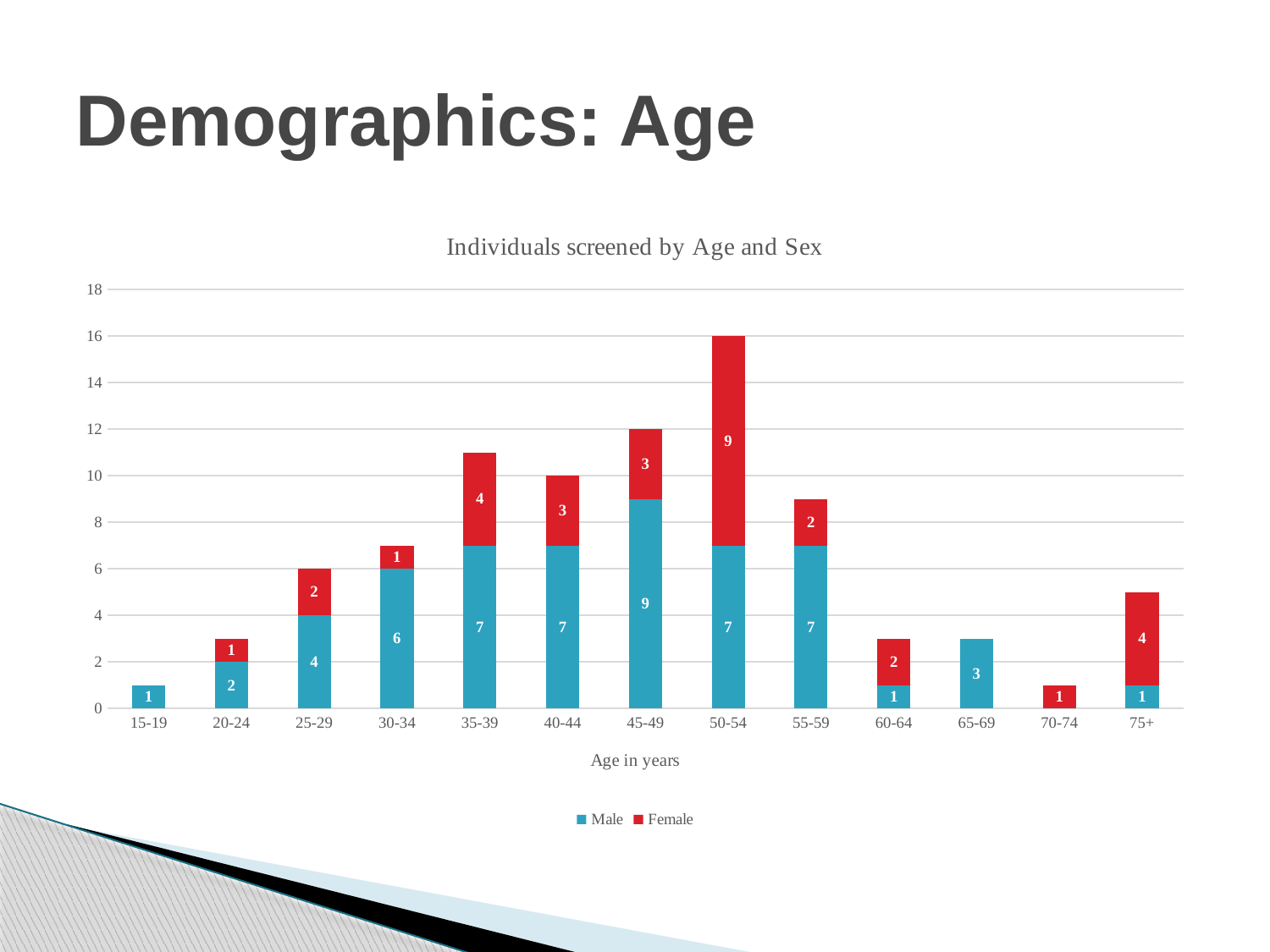
What is the difference between the Female values for 50-54 and 55-59? 7 What is the total of the stacked bar for the 50-54 age group? 16 How many age groups are shown on the x axis? 13 What is the Female value for the 50-54 age group? 9 Which is larger, the Male value for 30-34 or the Male value for 25-29? 30-34 What type of chart is shown on the slide? Stacked bar chart How many series does the legend list? 2 Which age group has the highest Male value? 45-49 What is the Male value for the 45-49 age group? 9 What is the total of the stacked bar for the 35-39 age group? 11 What is the Female value for the 75+ age group? 4 Which age group has the tallest stacked bar overall? 50-54